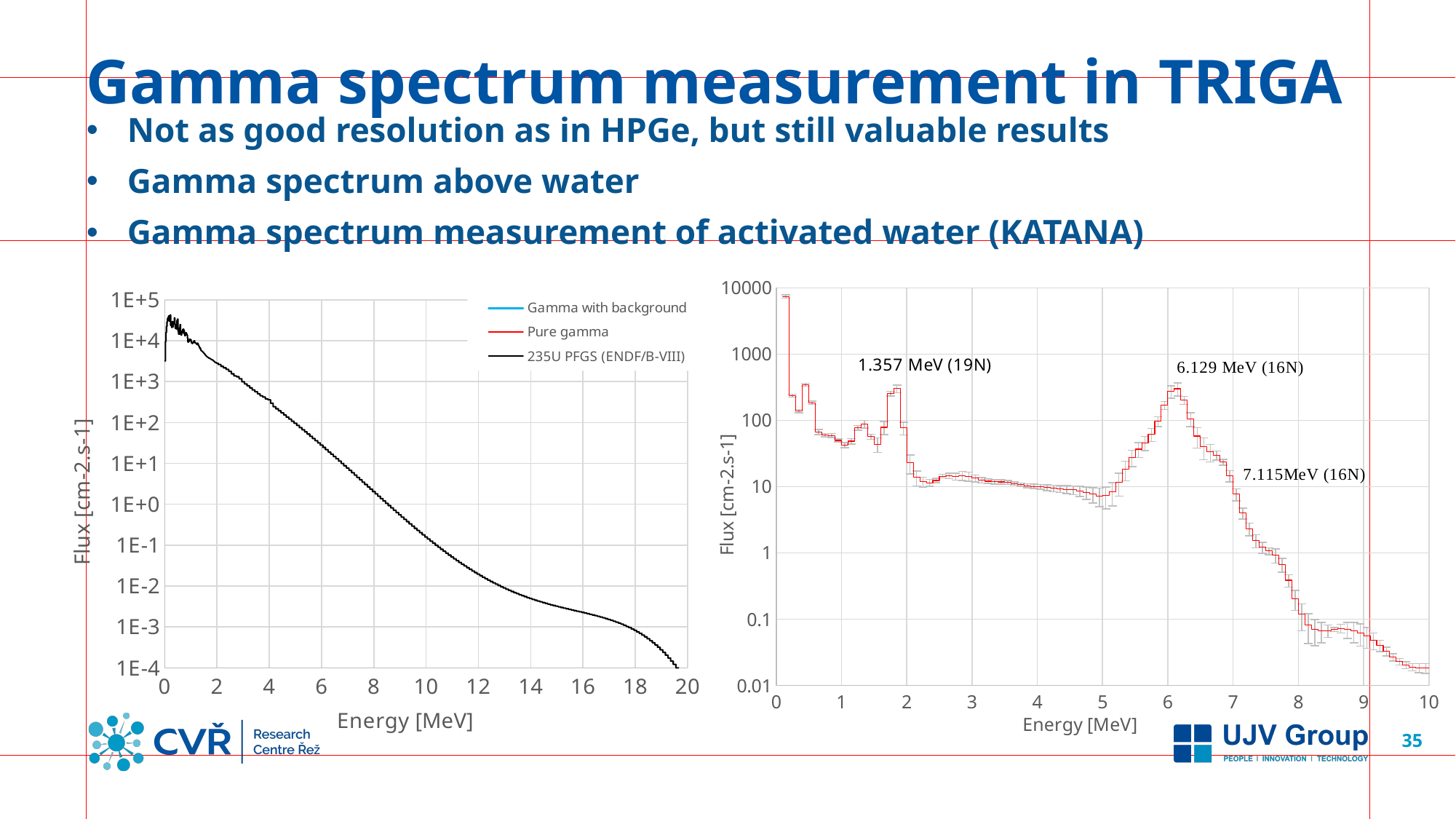
On the right chart, is the flux at the 6.129 MeV peak greater or less than 100? greater On the left chart, what is the name of the third series in the legend? 235U PFGS (ENDF/B-VIII) What kind of chart is the left chart? line chart On the right chart, what energy is labelled for the 16N peak near 6 MeV? 6.129 MeV What kind of chart is the right chart? line chart What is the x-axis label of the left chart? Energy [MeV] On the left chart, is the flux at 14 MeV greater or less than 1E-1? less On the right chart, is the flux at 10 MeV greater or less than 0.1? less On the right chart, which isotope is labelled at the 1.357 MeV peak? 19N On the left chart, do the flux values rise or fall as energy increases from 2 MeV to 20 MeV? fall How many series does the legend of the left chart list? 3